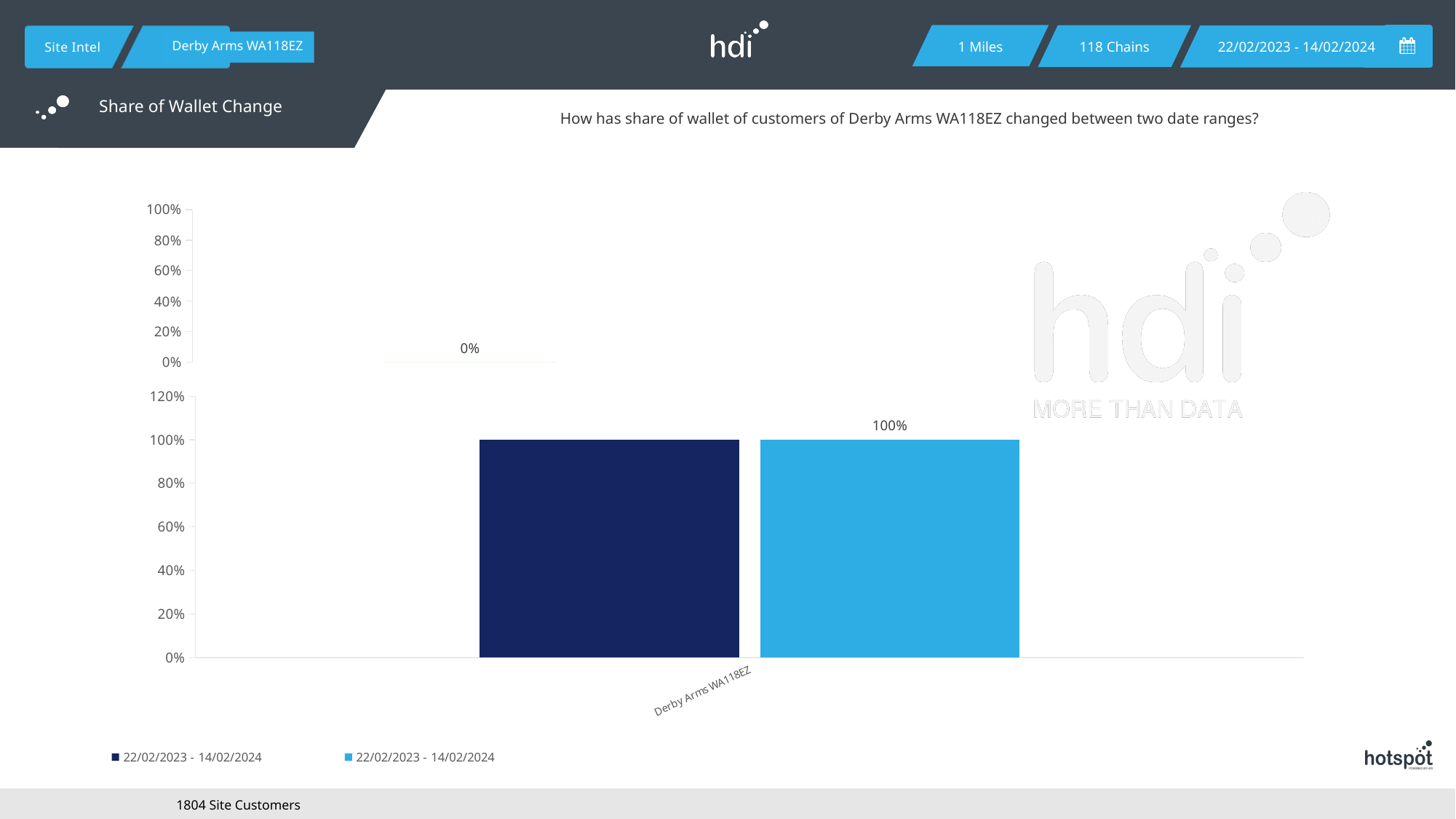
In the lower chart, what value is printed above the light blue bar for Derby Arms WA118EZ? 100% In the lower chart, is the value of the light blue bar greater or less than 20%? greater What is the highest tick shown on the y axis of the upper chart? 100% In the upper chart, what value is printed as the data label? 0% What is the highest tick shown on the y axis of the lower chart? 120% How many series does the legend of the lower chart list? 2 In the lower chart, do the dark blue bar and the light blue bar reach the same value? yes What is the category label on the x axis of the lower chart? Derby Arms WA118EZ In the lower chart, what value does the dark blue bar for Derby Arms WA118EZ reach on the y axis? 100% What kind of chart is the lower chart on the slide? bar chart In the lower chart, is the value of the dark blue bar greater or less than 60%? greater How many categories are shown on the x axis of the lower chart? 1